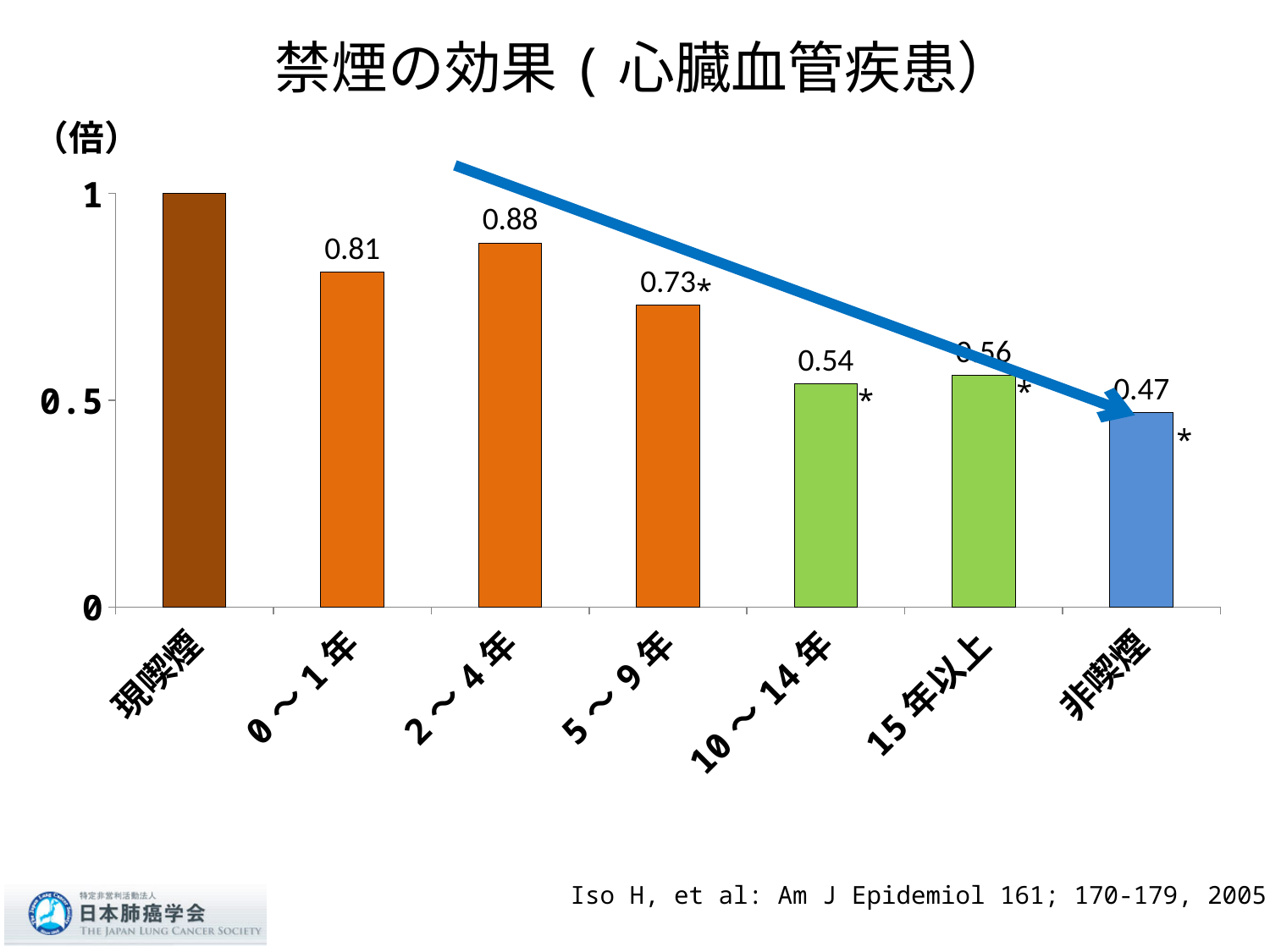
What is the value for 非喫煙? 0.47 What kind of chart is shown on the slide? bar chart Which is larger, the value for 2～4年 or the value for 5～9年? 2～4年 What is the difference between the values for 2～4年 and 0～1年? 0.07 How many categories are shown on the x axis? 7 What is the value for 10～14年? 0.54 Which category has the highest value? 現喫煙 What is the value for 2～4年? 0.88 What is the value for 0～1年? 0.81 Which category has the lowest value? 非喫煙 What is the value for 5～9年? 0.73 Is the value for 15年以上 greater or less than 0.5? greater